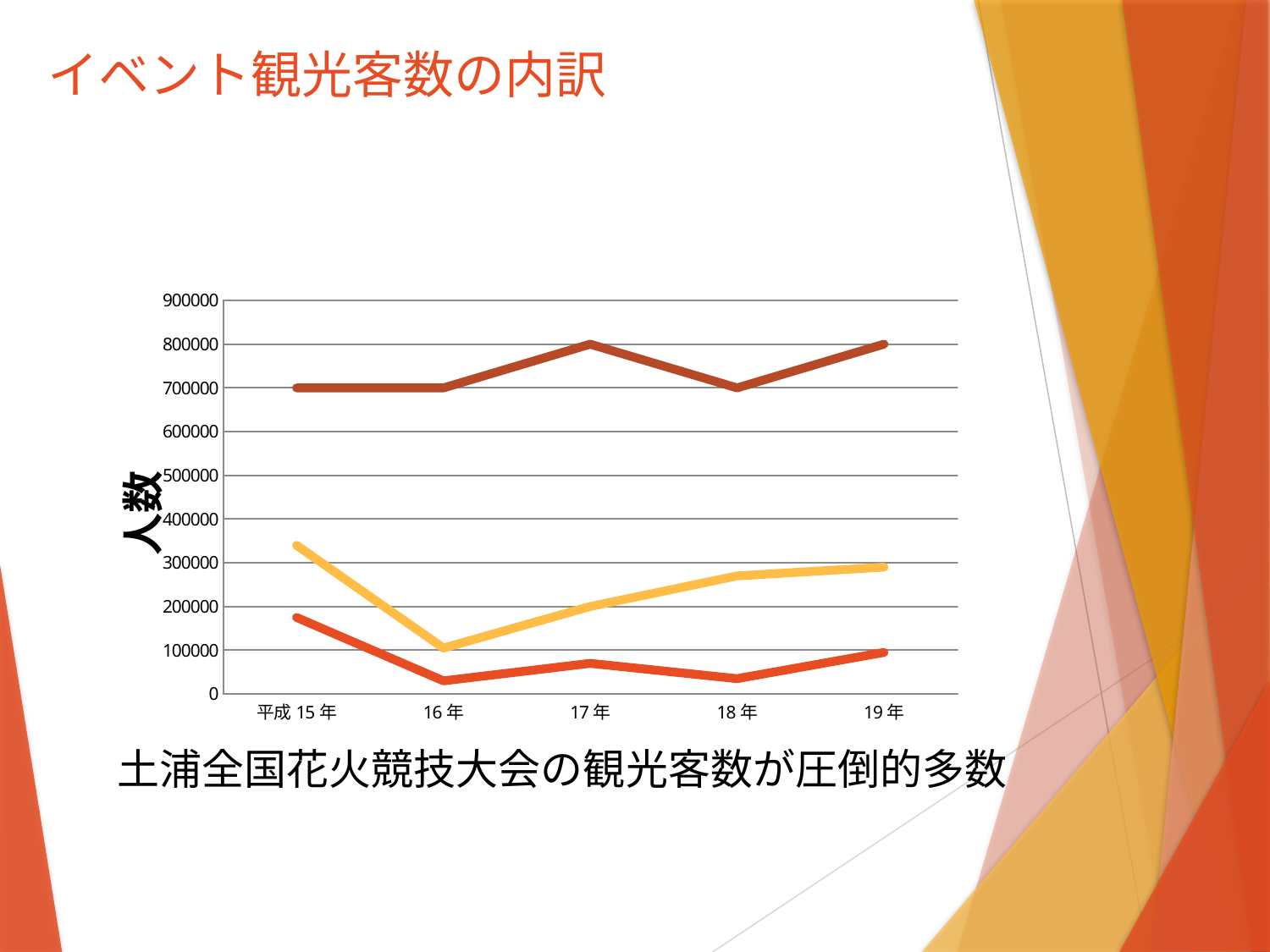
What is the value of the dark brown (top) line at 平成15年? 700000 What is the value of the dark brown (top) line at 17年? 800000 Which line has the highest value at 平成15年? the dark brown (top) line Is the value of the yellow line at 平成15年 greater or less than 300000? greater Is the value of the dark brown (top) line at 18年 greater or less than 750000? less How many years are shown along the x axis of the chart? 5 In which year is the yellow line at its lowest? 16年 What kind of chart is shown on the slide? line chart How many lines are plotted on the chart? 3 Is the value of the orange-red (bottom) line at 16年 greater or less than 100000? less Does the yellow line rise or fall from 16年 to 19年? rises What is the label on the vertical axis of the chart? 人数